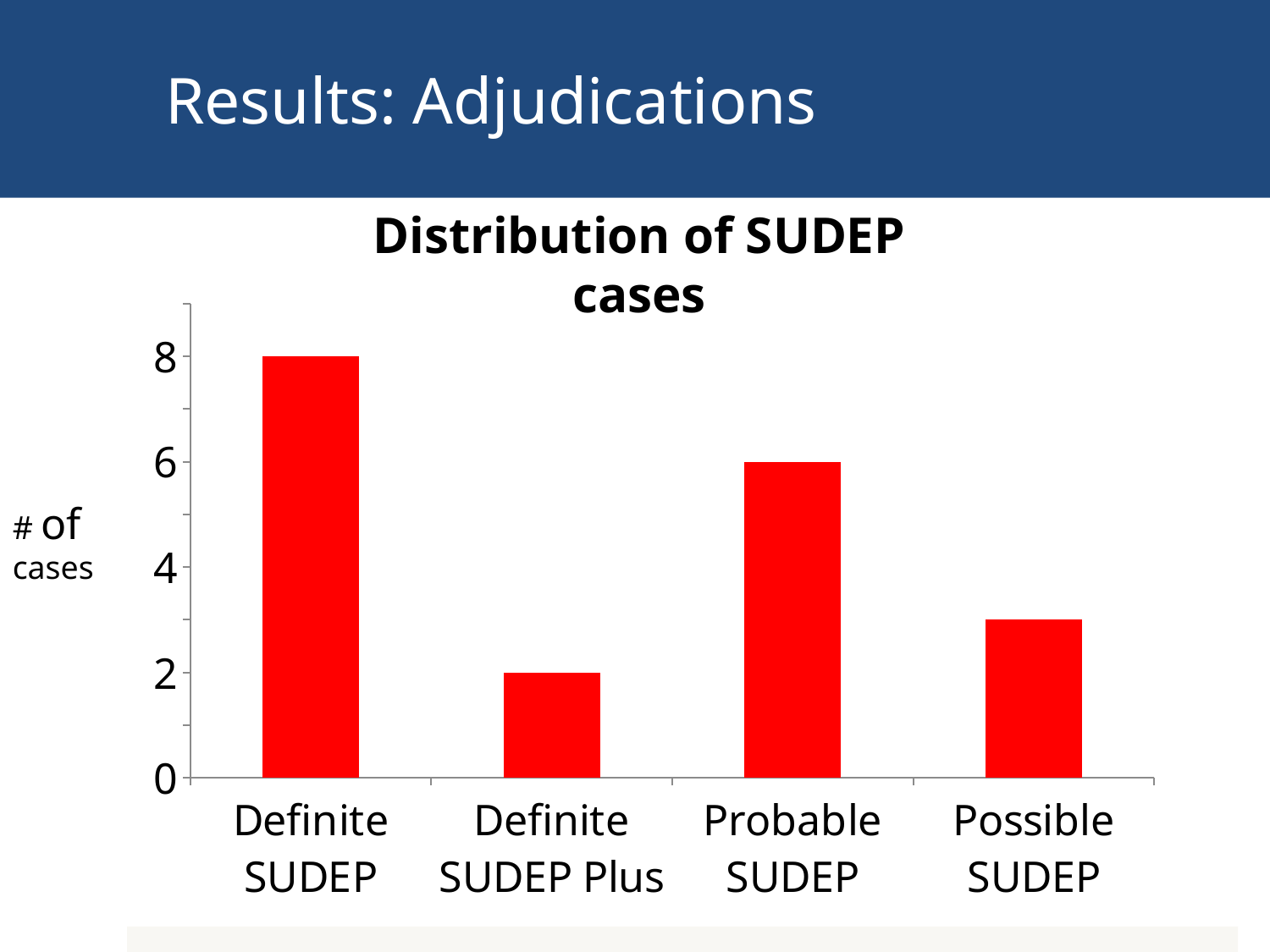
Which category has the lowest number of cases? Definite SUDEP Plus What is the difference in cases between Definite SUDEP and Probable SUDEP? 2 What is the title of the chart? Distribution of SUDEP cases Which has more cases, Probable SUDEP or Possible SUDEP? Probable SUDEP What is the difference in cases between Probable SUDEP and Definite SUDEP Plus? 4 What is the number of cases for Probable SUDEP? 6 How many categories are shown on the x axis? 4 What is the number of cases for Definite SUDEP Plus? 2 What is the number of cases for Definite SUDEP? 8 What kind of chart is shown on the slide? Bar chart Which category has the highest number of cases? Definite SUDEP Is the value for Possible SUDEP greater or less than 4? less